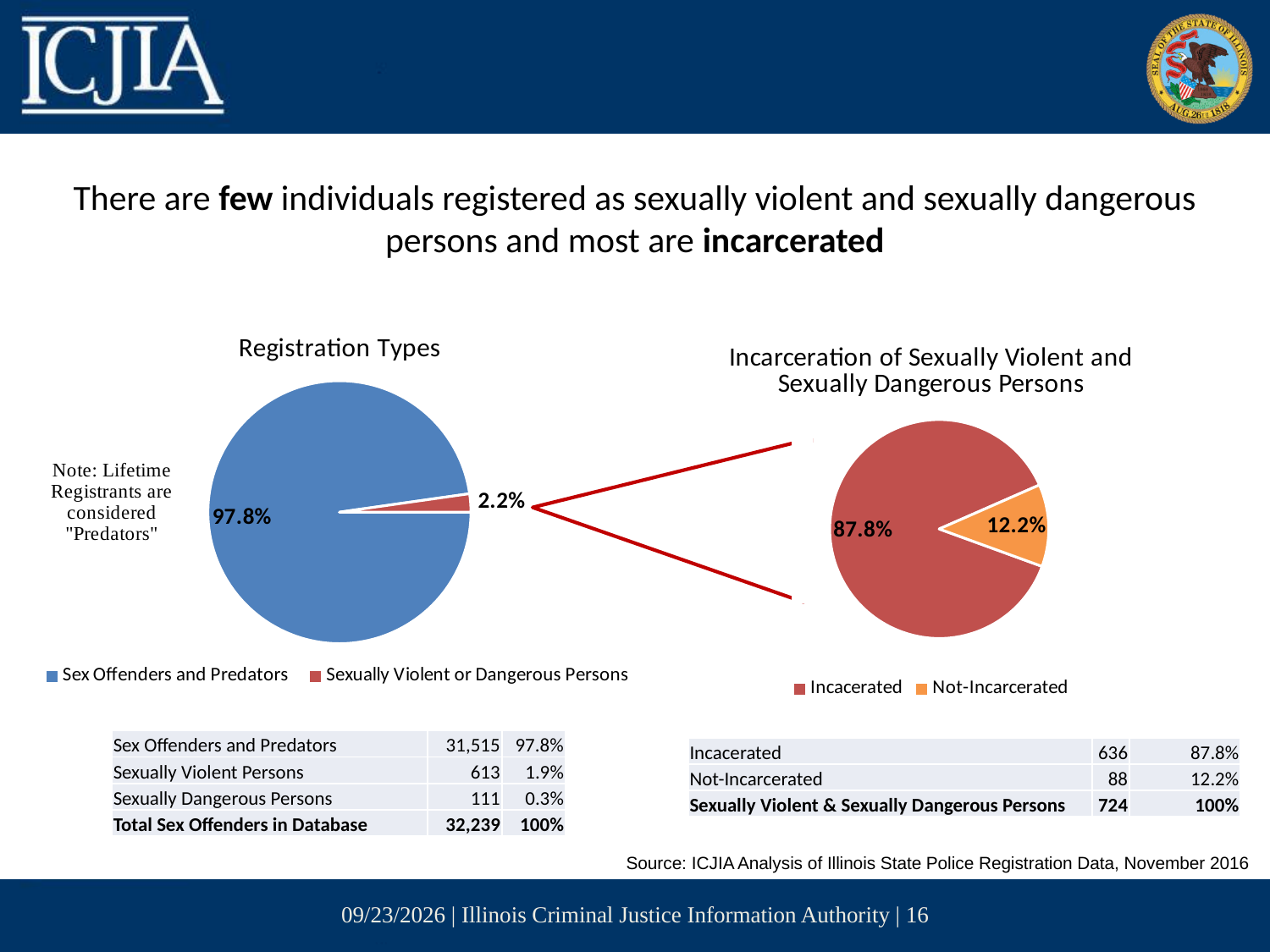
In the 'Registration Types' chart, what percentage is shown for Sexually Violent or Dangerous Persons? 2.2% In the 'Registration Types' chart, what is the difference in percentage points between Sex Offenders and Predators and Sexually Violent or Dangerous Persons? 95.6 In the 'Incarceration of Sexually Violent and Sexually Dangerous Persons' chart, what colour is the Not-Incarcerated slice? Orange In the 'Incarceration of Sexually Violent and Sexually Dangerous Persons' chart, what is the difference in percentage points between Incarcerated and Not-Incarcerated? 75.6 How many slices does the 'Registration Types' pie chart have? 2 In the 'Registration Types' chart, what percentage is shown for Sex Offenders and Predators? 97.8% In the 'Incarceration of Sexually Violent and Sexually Dangerous Persons' chart, what percentage is shown for Incarcerated? 87.8% In the 'Registration Types' chart, which category has the largest slice? Sex Offenders and Predators In the 'Incarceration of Sexually Violent and Sexually Dangerous Persons' chart, what percentage is shown for Not-Incarcerated? 12.2% How many categories does the legend of the 'Incarceration of Sexually Violent and Sexually Dangerous Persons' chart list? 2 What type of chart is the 'Registration Types' chart? Pie chart In the 'Incarceration of Sexually Violent and Sexually Dangerous Persons' chart, which category has the smallest slice? Not-Incarcerated